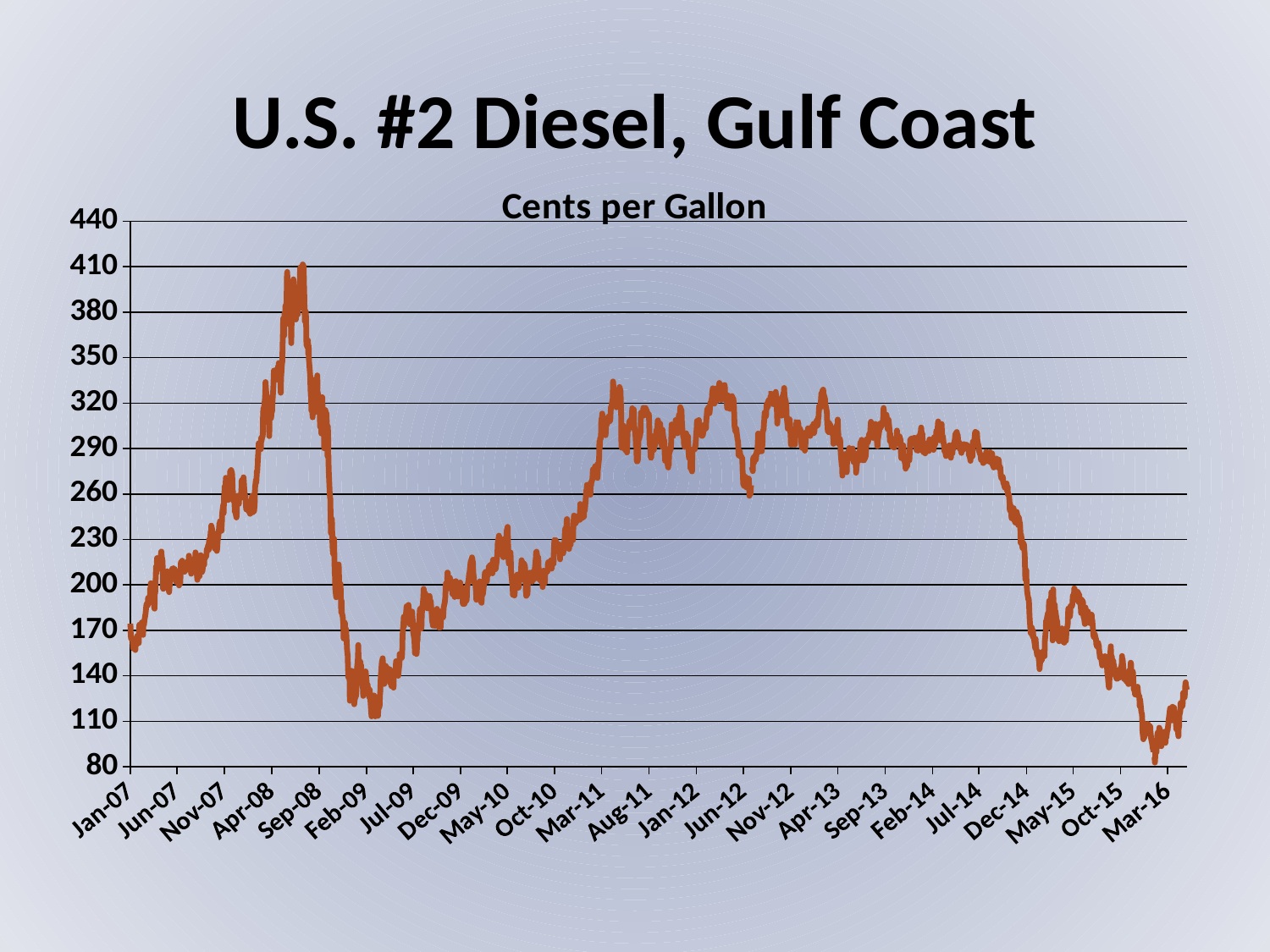
Does the diesel price rise or fall between Jan-07 and Sep-08? rise Is the peak value near Sep-08 greater or less than 380? greater Is the value at Mar-16 greater or less than 170? less What is the title of the chart? U.S. #2 Diesel, Gulf Coast Around which x-axis label does the diesel price reach its highest point? Sep-08 What kind of chart is shown on the slide? line chart Is the value at Jan-12 greater or less than 260? greater How many lines (data series) are plotted on the chart? 1 Does the diesel price rise or fall between Jul-14 and Mar-16? fall What unit is the chart's subtitle stated in? Cents per Gallon Around which x-axis label does the diesel price reach its lowest point? Mar-16 How many date labels are shown along the x axis? 23